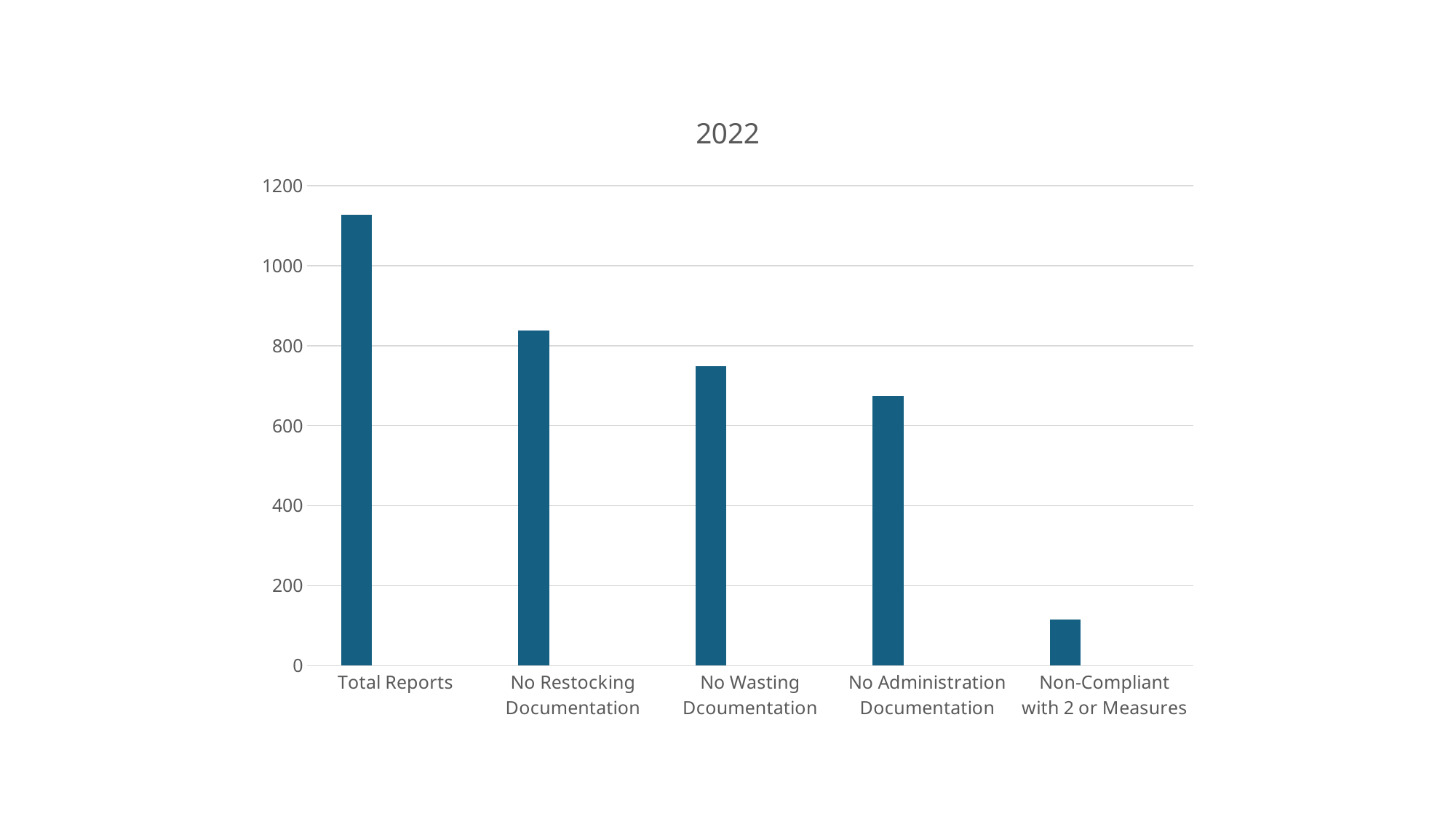
Which is larger, the value for No Restocking Documentation or the value for No Administration Documentation? No Restocking Documentation Do the values rise or fall from left to right along the x axis? fall How many categories are shown on the x axis? 5 Which category has the lowest value? Non-Compliant with 2 or Measures Which category has the highest value? Total Reports Is the value for No Restocking Documentation greater or less than 800? greater Is the value for Total Reports greater or less than 1000? greater Is the value for No Wasting Dcoumentation greater or less than 800? less What kind of chart is shown on the slide? bar chart What is the title of the chart? 2022